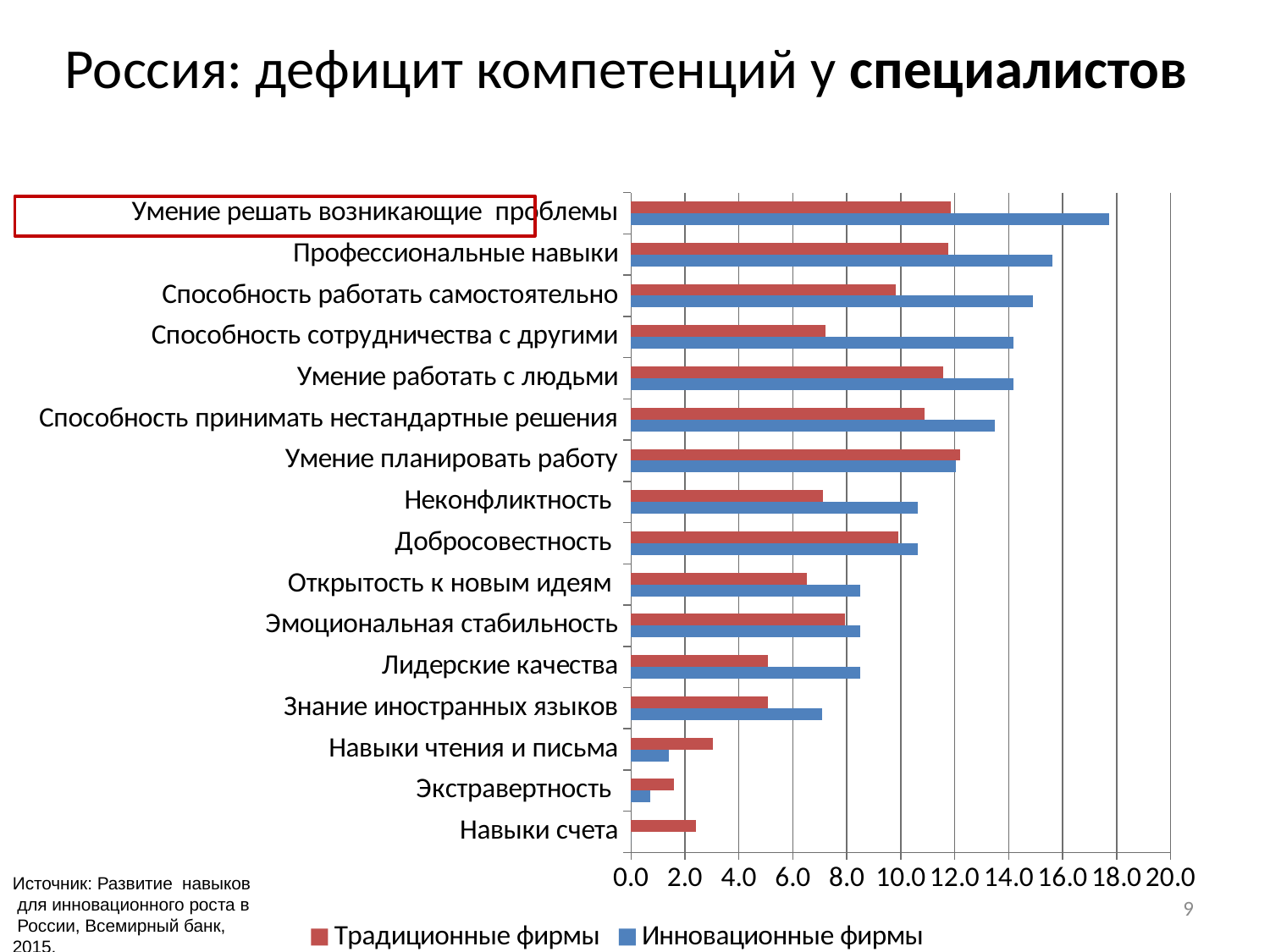
Is the value for Инновационные фирмы in Знание иностранных языков greater or less than 8.0? less How many competency categories are plotted on the chart? 16 For Навыки чтения и письма, which series has the larger value: Традиционные фирмы or Инновационные фирмы? Традиционные фирмы Is the value for Традиционные фирмы in Способность сотрудничества с другими greater or less than 8.0? less For Лидерские качества, which series has the larger value: Традиционные фирмы or Инновационные фирмы? Инновационные фирмы Is the value for Традиционные фирмы in Навыки чтения и письма greater or less than 2.0? greater What kind of chart is shown on the slide? Bar chart Which category has the highest value for Инновационные фирмы? Умение решать возникающие проблемы Which colour represents Традиционные фирмы in the legend? Red Which category has the lowest value for Традиционные фирмы? Экстравертность How many series does the legend list? 2